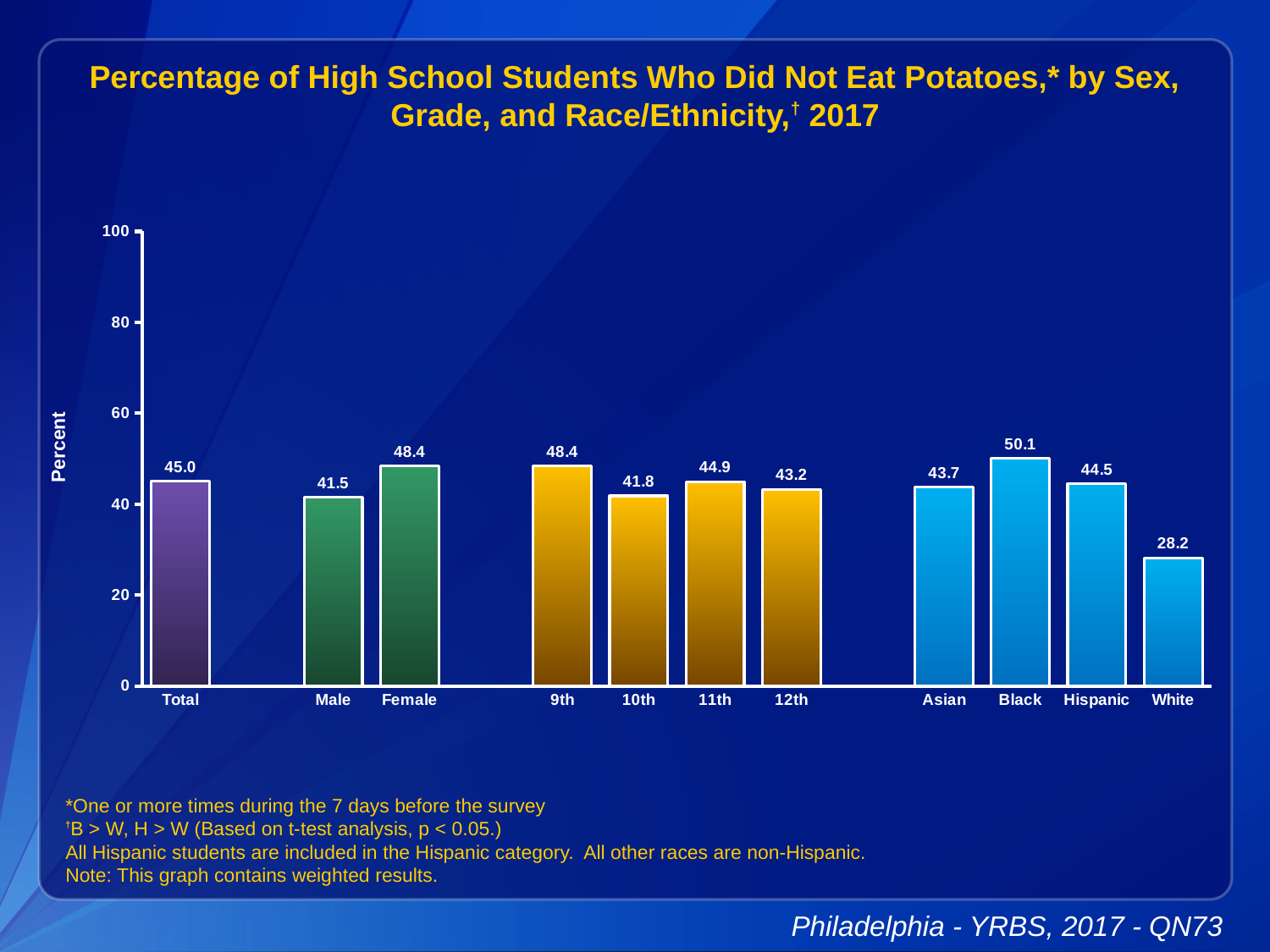
What is the label on the y axis? Percent How many categories are shown on the x axis? 11 What is the value for Female? 48.4 Which category has the lowest value? White What is the value for 10th grade? 41.8 Which is larger, the value for Asian or the value for Hispanic? Hispanic What is the difference between the values for Female and Male? 6.9 Which category has the highest value? Black Is the value for 9th grade greater or less than 40? greater What is the value for Total? 45.0 What kind of chart is shown on the slide? bar chart What is the value for White? 28.2